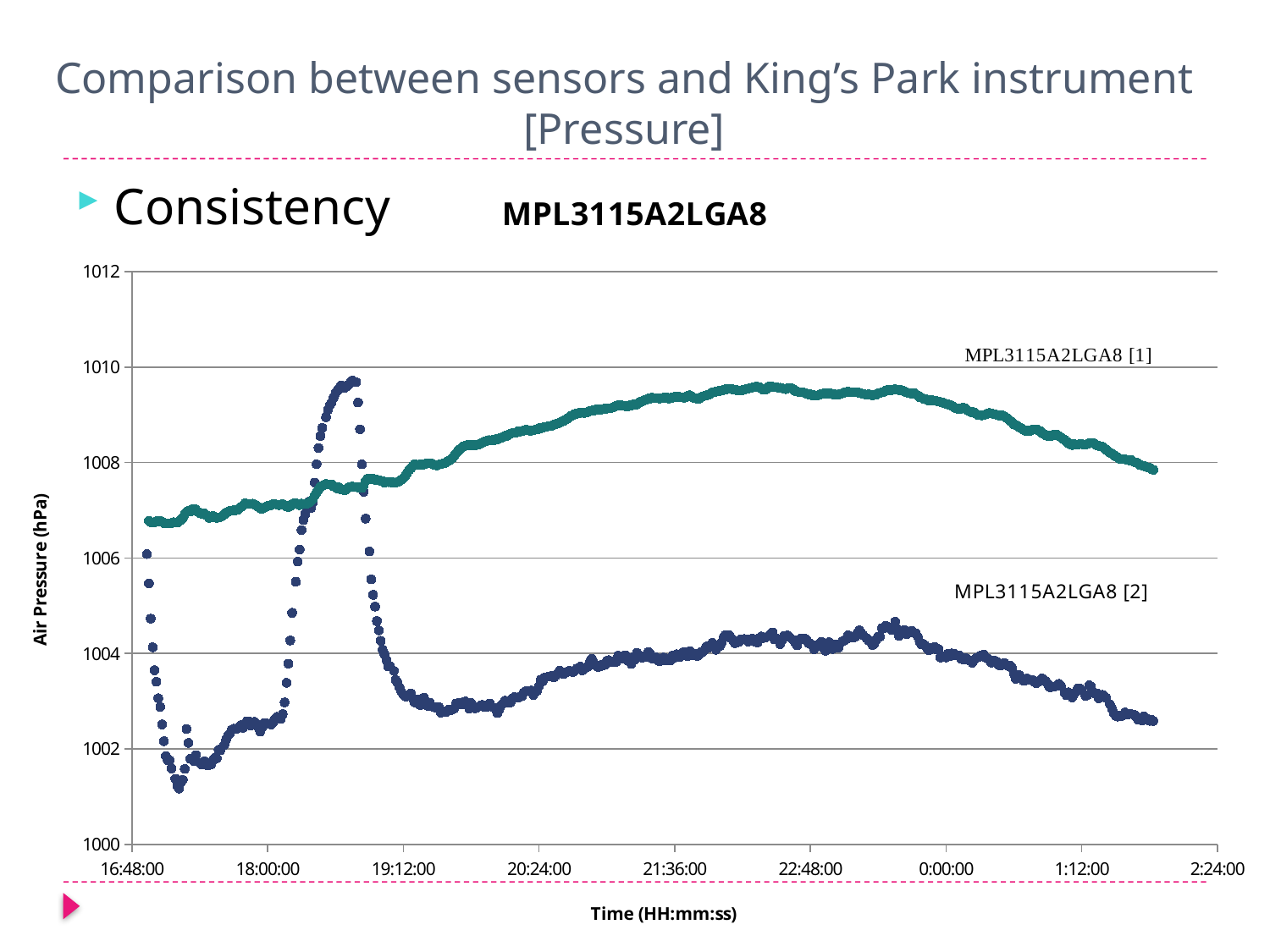
Is the value for MPL3115A2LGA8 [2] at 20:24:00 greater or less than 1004? less What kind of chart is shown on the slide? scatter chart Is the lowest value reached by MPL3115A2LGA8 [2] greater or less than 1002? less Which series has the lower value at 0:00:00, MPL3115A2LGA8 [1] or MPL3115A2LGA8 [2]? MPL3115A2LGA8 [2] Do the values for MPL3115A2LGA8 [1] rise or fall between 0:00:00 and the end of the series? fall Do the values for MPL3115A2LGA8 [1] rise or fall between 19:12:00 and 21:36:00? rise What is the title of the chart? MPL3115A2LGA8 Which series has the higher value at 22:48:00, MPL3115A2LGA8 [1] or MPL3115A2LGA8 [2]? MPL3115A2LGA8 [1] What is the label of the vertical axis? Air Pressure (hPa) Is the value for MPL3115A2LGA8 [1] at 22:48:00 greater or less than 1008? greater How many data series are plotted on the chart? 2